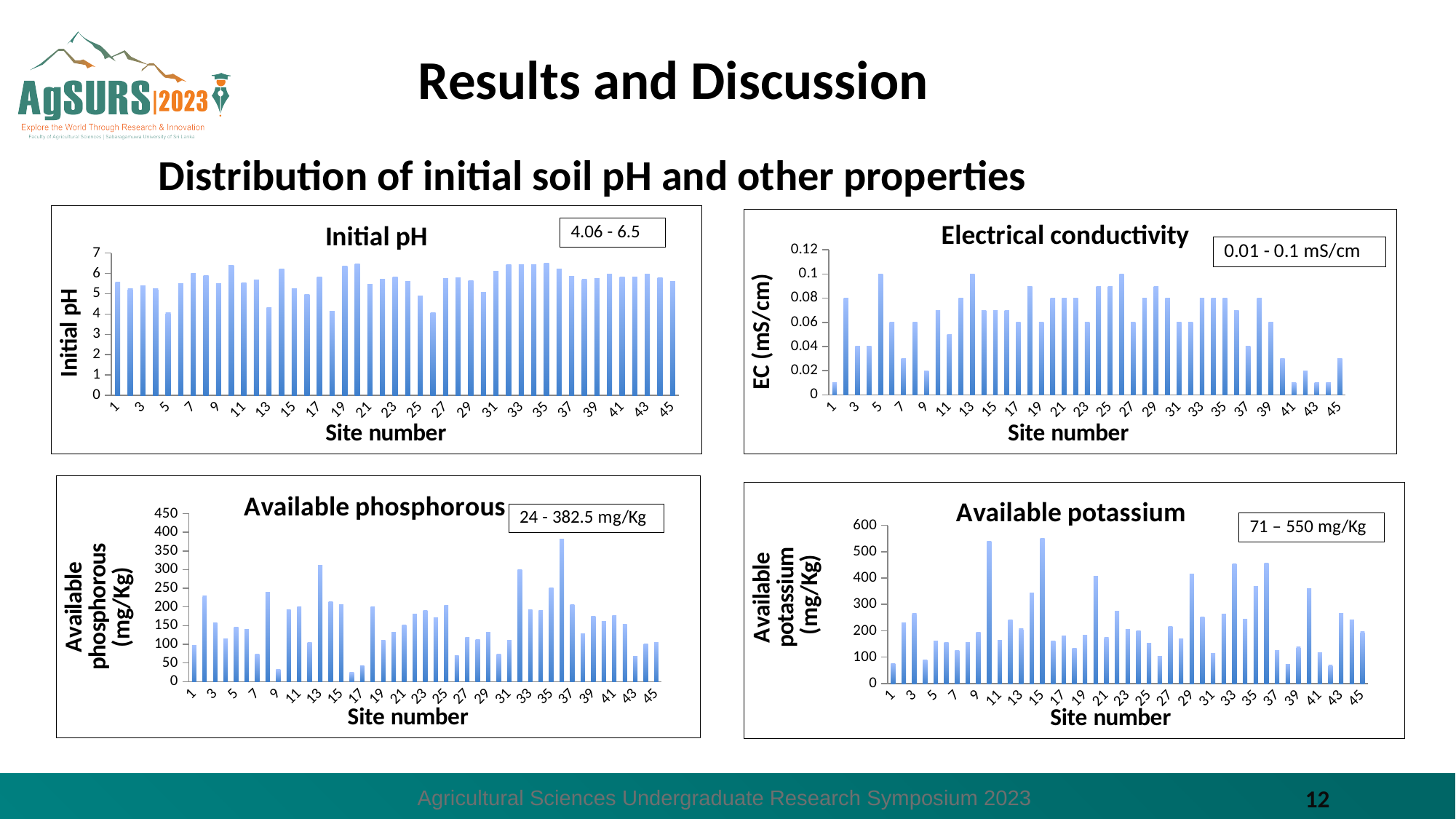
What is the y-axis label of the Electrical conductivity chart? EC (mS/cm) In the Available phosphorous chart, which site number has the highest value? 36 In the Initial pH chart, is the value for site 1 greater or less than 5? greater In the Electrical conductivity chart, which is larger, the value for site 5 or the value for site 9? site 5 In the Electrical conductivity chart, is the value for site 41 greater or less than 0.02? less In the Available phosphorous chart, is the value for site 37 greater or less than 350? less How many sites are plotted on the x axis of the Electrical conductivity chart? 45 What range is printed in the box on the Available potassium chart? 71 – 550 mg/Kg What kind of chart is the Initial pH chart? bar chart In the Available phosphorous chart, which is larger, the value for site 13 or the value for site 17? site 13